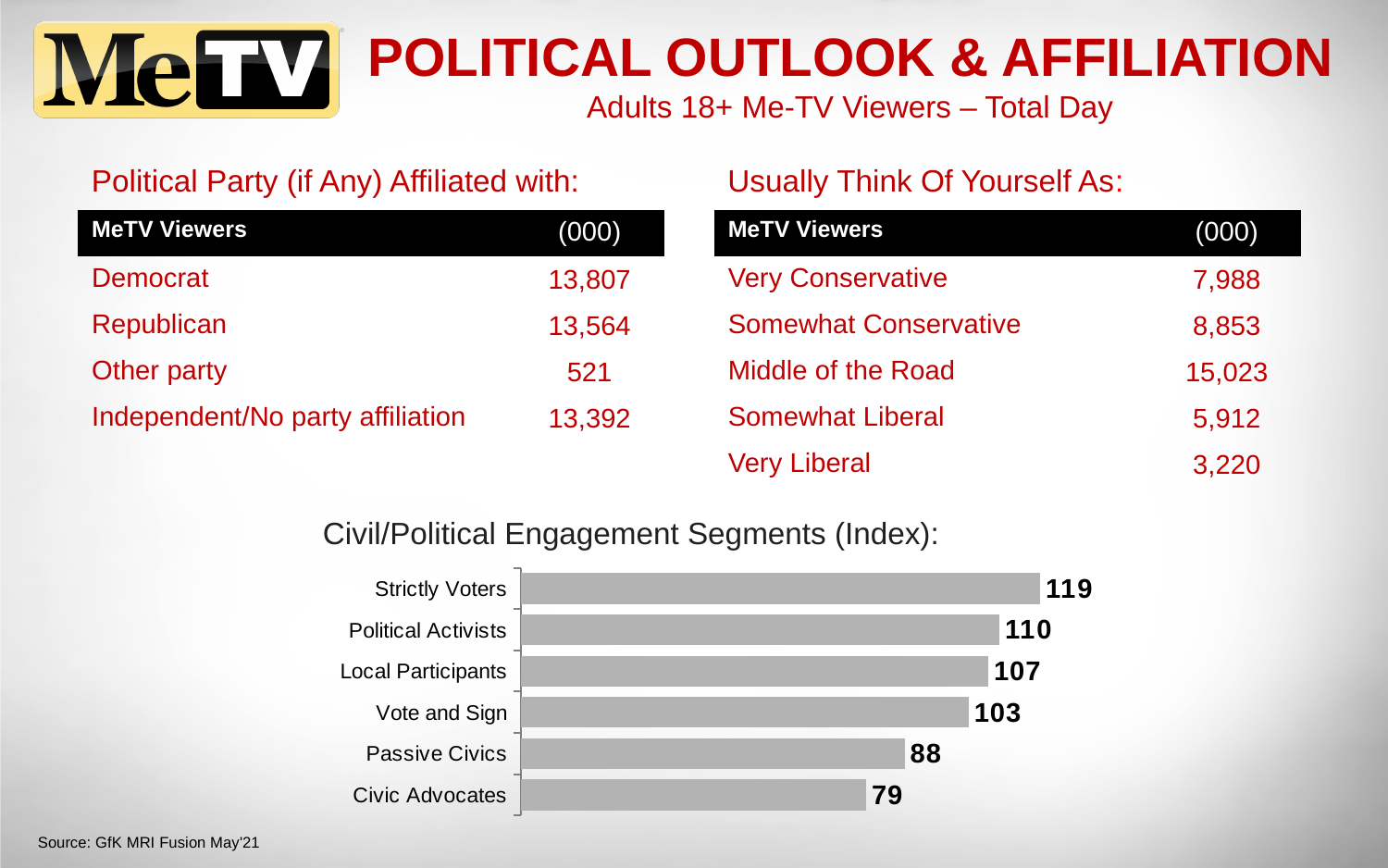
In the Civil/Political Engagement Segments chart, what is the difference between the index for Strictly Voters and Civic Advocates? 40 In the Civil/Political Engagement Segments chart, which segment has the lowest index? Civic Advocates In the Civil/Political Engagement Segments chart, which segment has the highest index? Strictly Voters In the Civil/Political Engagement Segments chart, what is the index value for Vote and Sign? 103 In the Civil/Political Engagement Segments chart, do the index values increase or decrease from the top bar to the bottom bar? Decrease In the Civil/Political Engagement Segments chart, which has a higher index, Passive Civics or Vote and Sign? Vote and Sign In the Civil/Political Engagement Segments chart, what is the index value for Strictly Voters? 119 How many segments are shown in the Civil/Political Engagement Segments chart? 6 In the Civil/Political Engagement Segments chart, what is the difference between the index for Political Activists and Local Participants? 3 What type of chart is the Civil/Political Engagement Segments chart? Bar chart What is the title of the bar chart on the slide? Civil/Political Engagement Segments (Index): In the Civil/Political Engagement Segments chart, what is the index value for Passive Civics? 88